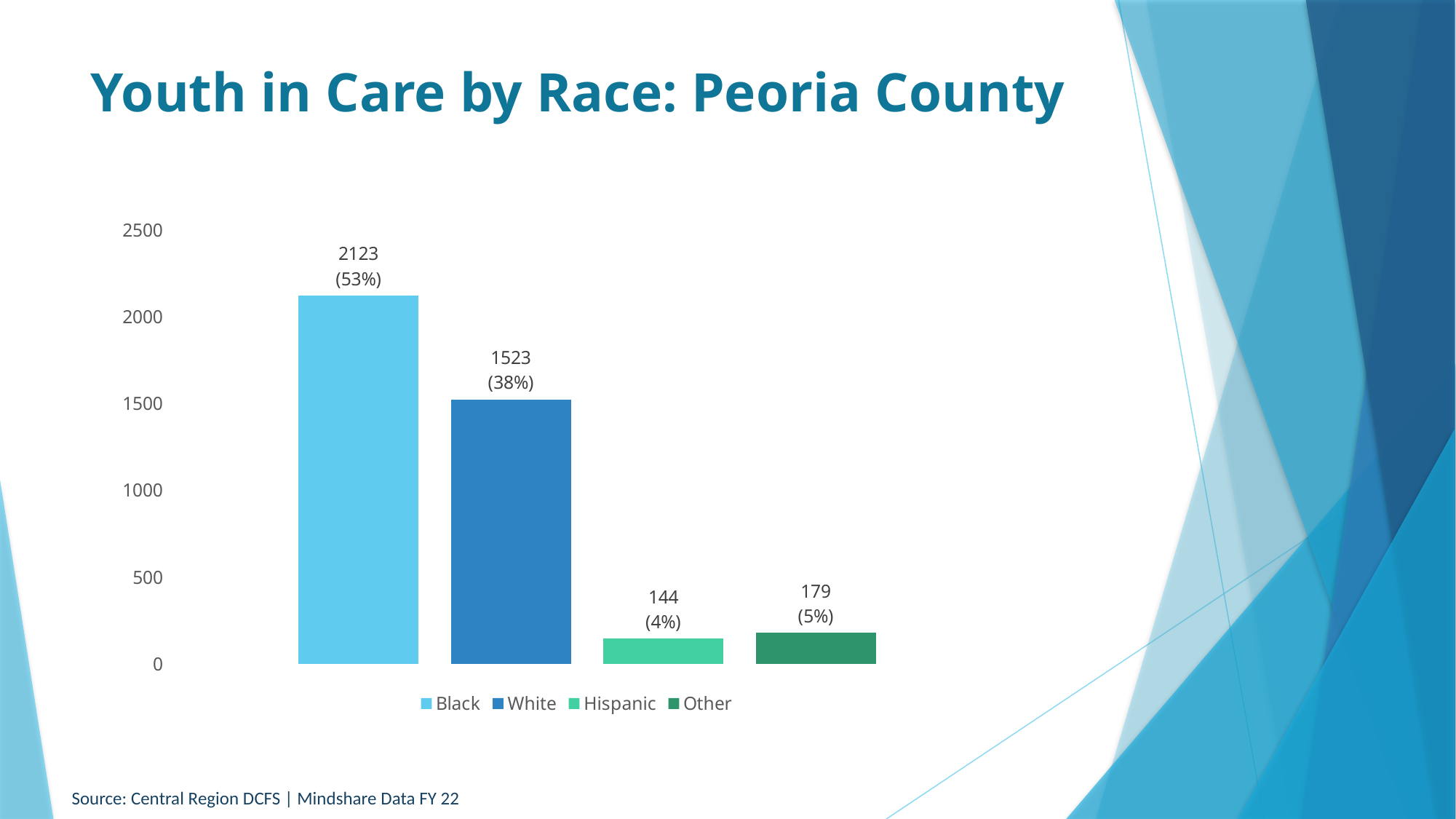
Which race category has the lowest number of youth in care? Hispanic How many race categories are shown in the chart? 4 What percentage of youth in care in Peoria County are labelled Other? 5% What is the title of the chart on the slide? Youth in Care by Race: Peoria County What is the number of youth in care for Hispanic youth in Peoria County? 144 Is the value for White youth in care greater or less than 2000? less What is the number of youth in care for Black youth in Peoria County? 2123 What is the difference between the number of Black and White youth in care? 600 Which race category has the highest number of youth in care? Black What kind of chart is shown on the slide? Bar chart What is the number of youth in care for White youth in Peoria County? 1523 Which has more youth in care, Hispanic or Other? Other